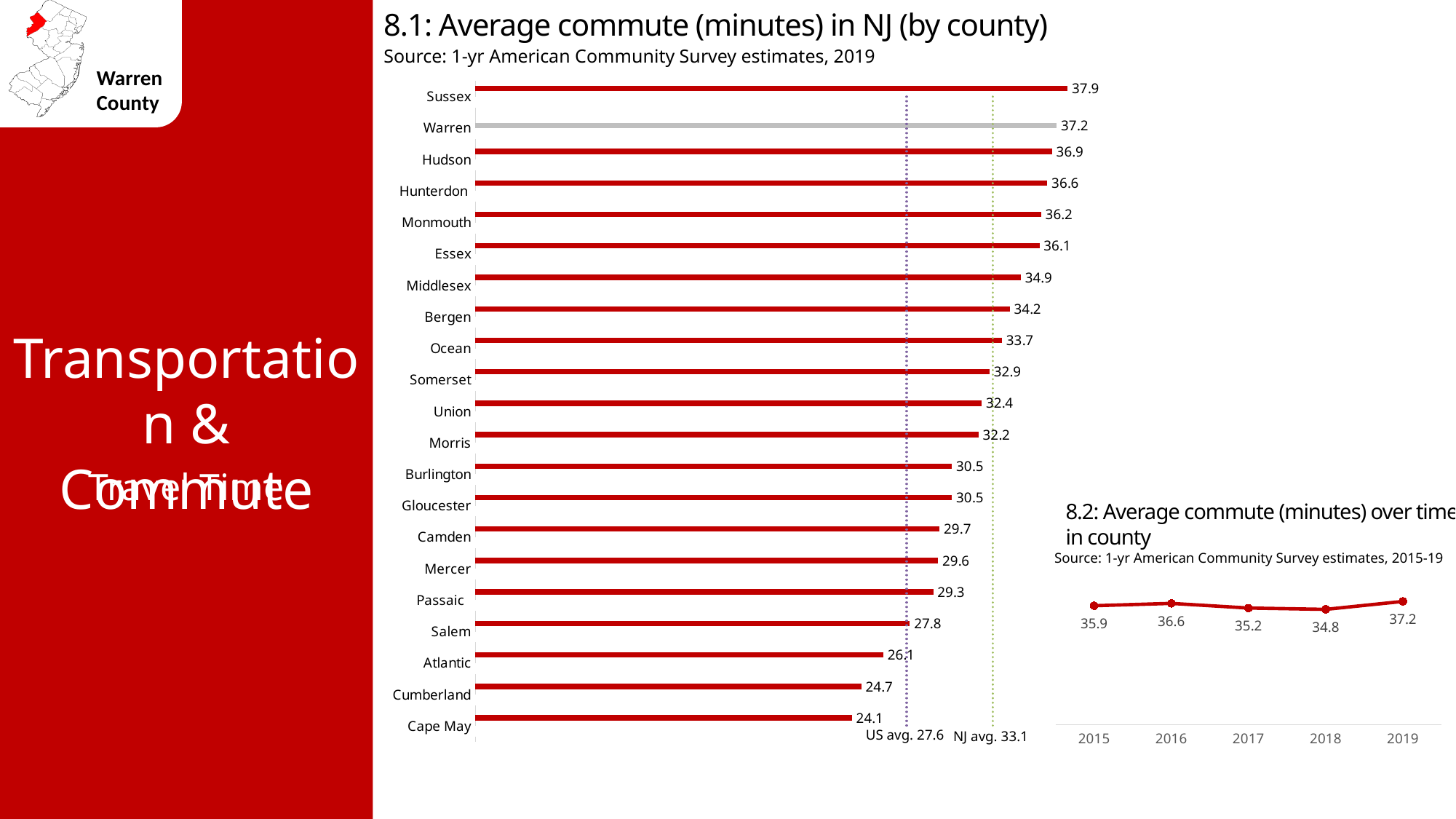
In chart 8.1 (Average commute in NJ by county), what is the average commute for Atlantic? 26.1 In chart 8.1 (Average commute in NJ by county), which has a longer average commute, Hudson or Bergen? Hudson In chart 8.1 (Average commute in NJ by county), which county has the lowest average commute? Cape May In chart 8.1 (Average commute in NJ by county), which county has the highest average commute? Sussex In chart 8.1 (Average commute in NJ by county), what is the average commute for Warren? 37.2 In chart 8.2 (Average commute over time in county), what is the value for 2017? 35.2 In chart 8.2 (Average commute over time in county), what is the difference between 2019 and 2018? 2.4 In chart 8.2 (Average commute over time in county), which year has the lowest value? 2018 In chart 8.1 (Average commute in NJ by county), what is the NJ average shown by the dotted reference line? 33.1 What kind of chart is chart 8.1 (Average commute in NJ by county)? Bar chart In chart 8.1 (Average commute in NJ by county), how many counties are shown? 21 In chart 8.1 (Average commute in NJ by county), what is the difference between Sussex and Cape May? 13.8